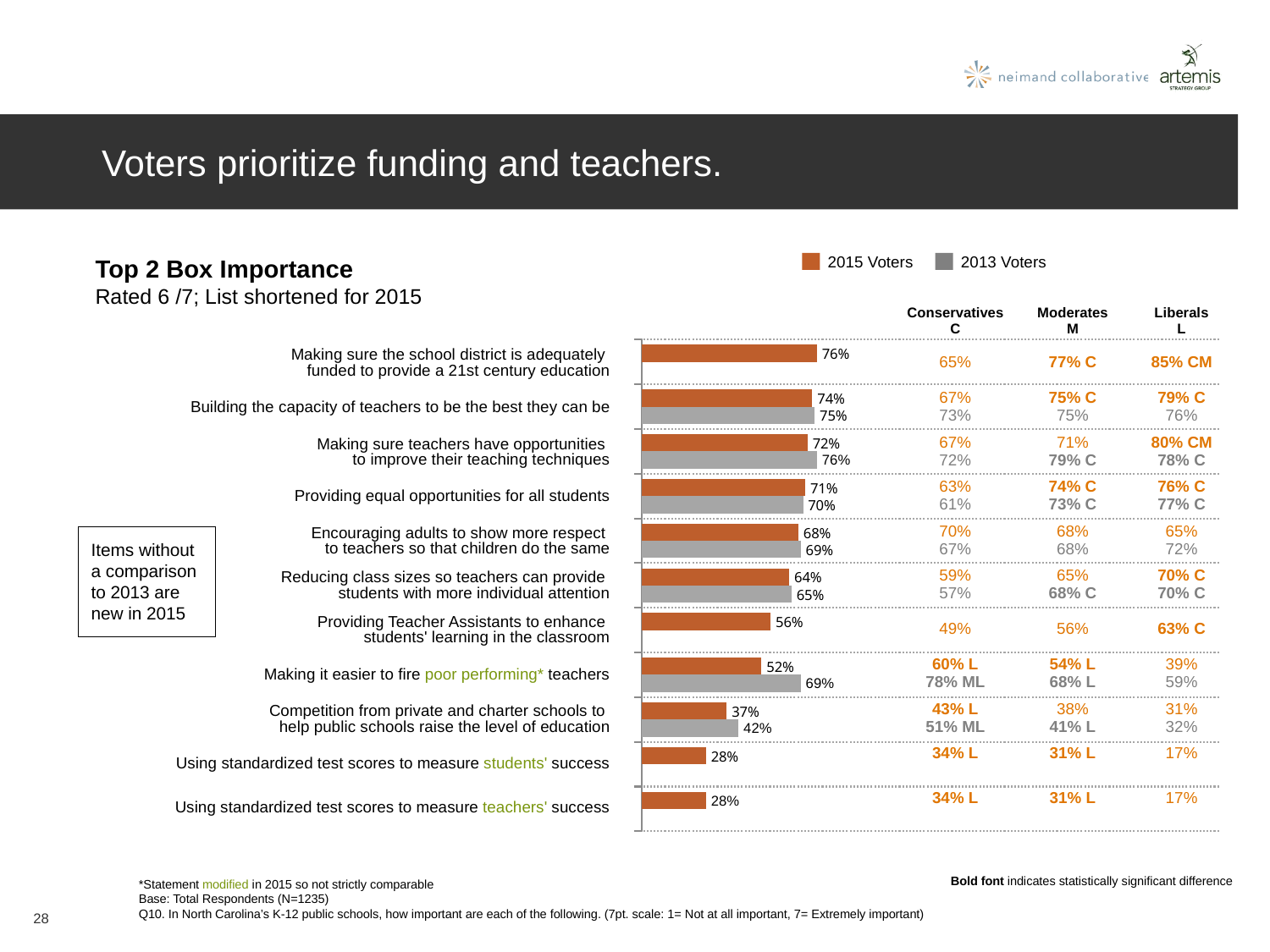
Which item has the lowest 2013 Voters value? Competition from private and charter schools to help public schools raise the level of education Which colour represents 2015 Voters in the chart? Orange What is the 2015 Voters value for "Making sure the school district is adequately funded to provide a 21st century education"? 76% What is the 2015 Voters value for "Providing Teacher Assistants to enhance students' learning in the classroom"? 56% How many series does the chart legend list? 2 For "Making sure teachers have opportunities to improve their teaching techniques", which is larger: the 2015 Voters value or the 2013 Voters value? 2013 Voters What kind of chart is shown on the slide? Bar chart How many items (categories) are shown in the chart? 11 What is the 2013 Voters value for "Making it easier to fire poor performing* teachers"? 69% What is the difference between the 2015 Voters and 2013 Voters values for "Providing equal opportunities for all students"? 1 percentage point Which item has the highest 2015 Voters value? Making sure the school district is adequately funded to provide a 21st century education What is the difference between the 2013 Voters and 2015 Voters values for "Making it easier to fire poor performing* teachers"? 17 percentage points